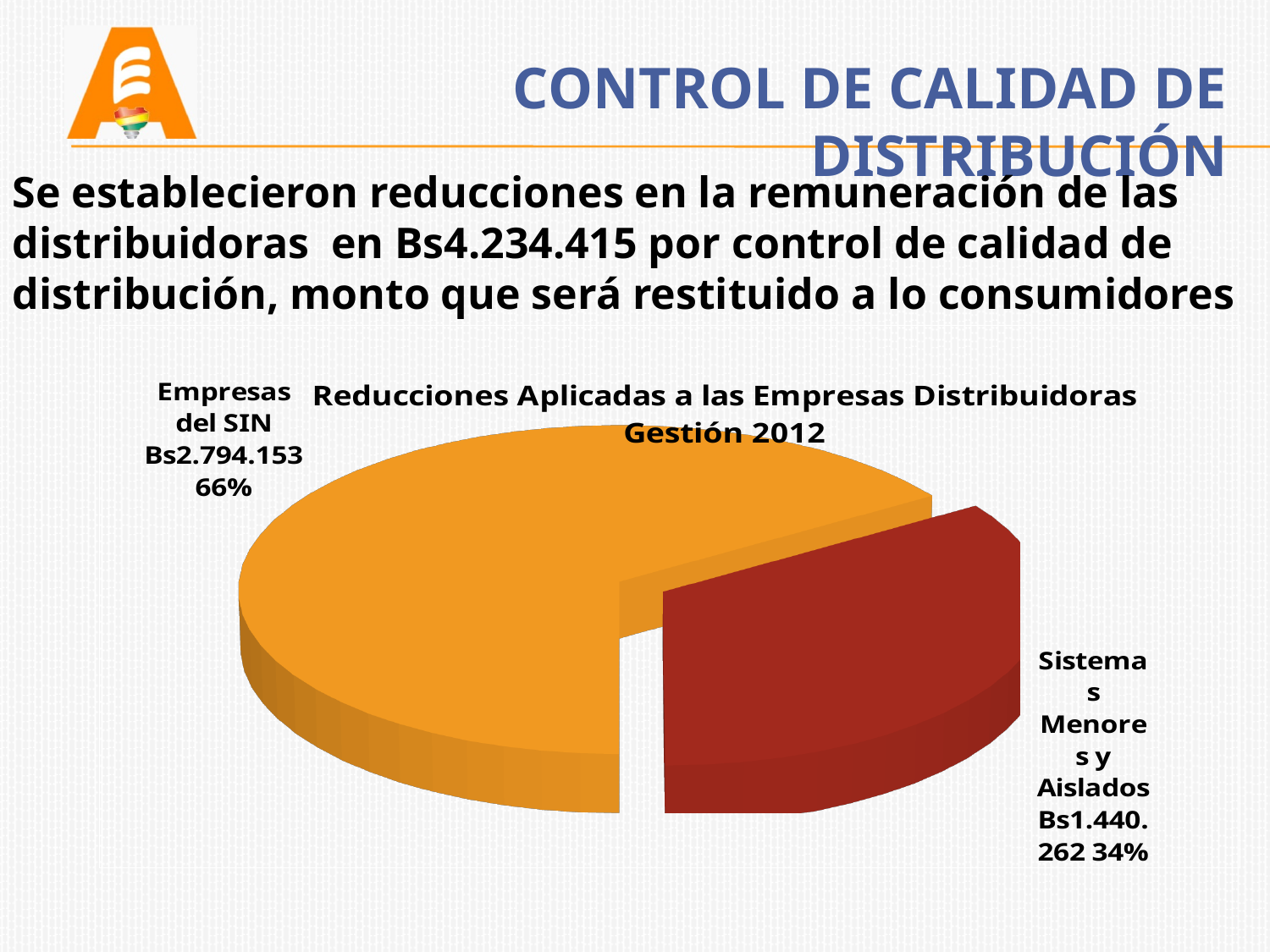
What is the difference between the value for Empresas del SIN and the value for Sistemas Menores y Aislados? Bs1.353.891 What share of the pie does Sistemas Menores y Aislados represent? 34% What colour is the slice for Sistemas Menores y Aislados? Red What kind of chart is shown on the slide? Pie chart What share of the pie does Empresas del SIN represent? 66% Which slice is the largest in the pie chart? Empresas del SIN What is the value shown for Empresas del SIN? Bs2.794.153 Which slice is the smallest in the pie chart? Sistemas Menores y Aislados Which is larger, the value for Empresas del SIN or the value for Sistemas Menores y Aislados? Empresas del SIN What is the value shown for Sistemas Menores y Aislados? Bs1.440.262 What is the title of the chart? Reducciones Aplicadas a las Empresas Distribuidoras Gestión 2012 How many slices does the pie chart have? 2